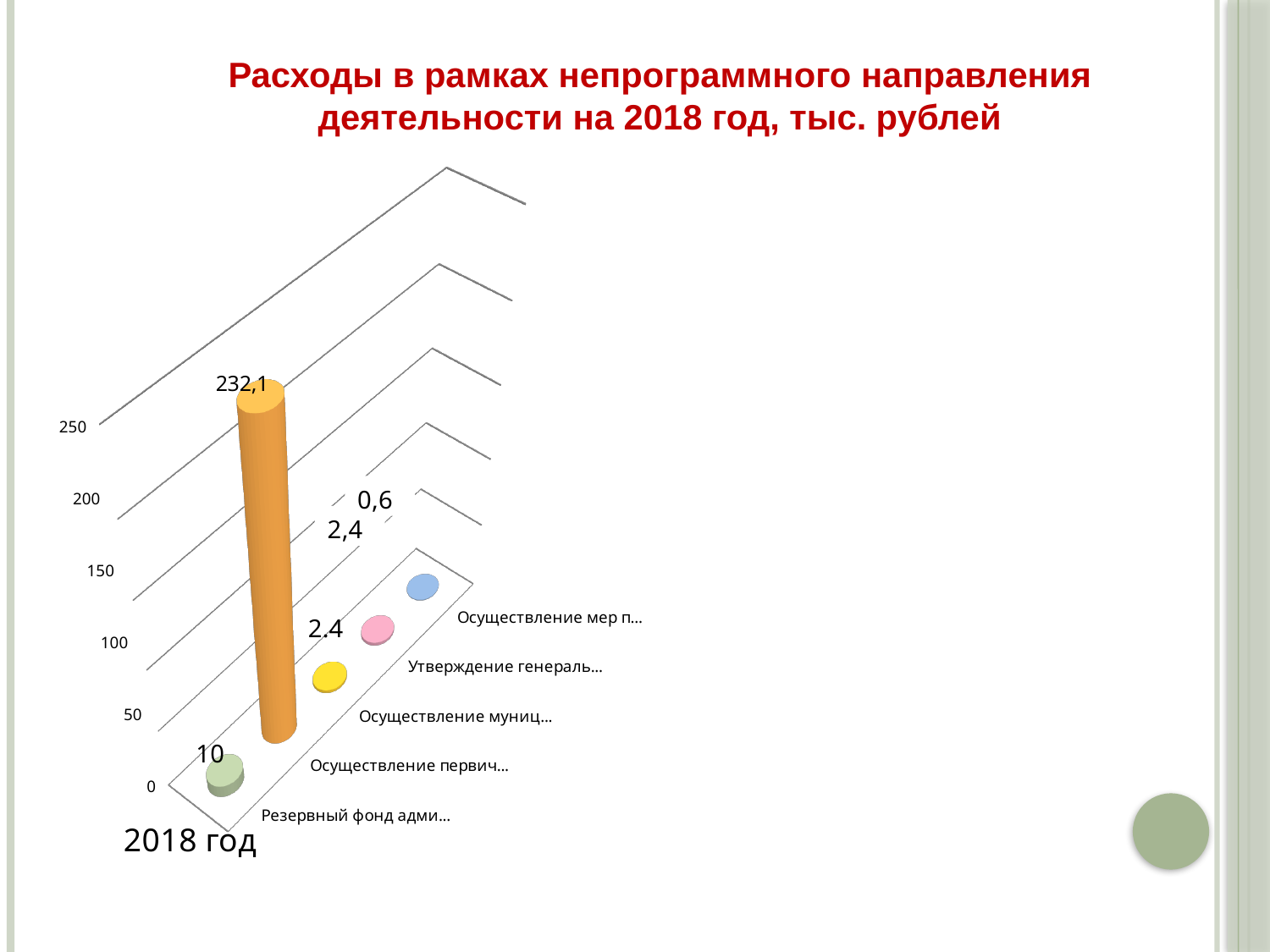
How many categories are plotted in the chart? 5 Which is larger: the value for 'Резервный фонд адми…' or the value for 'Осуществление муниц…'? Резервный фонд адми… What type of chart is shown on the slide? bar chart Which category has the lowest value? Осуществление мер п… What is the value for the category 'Резервный фонд адми…'? 10 Which year is labelled on the chart's horizontal axis? 2018 год What is the value of the tallest bar in the chart? 232,1 Which category has the highest value? Осуществление первич… What is the difference between the values for 'Осуществление первич…' and 'Резервный фонд адми…'? 222,1 Is the value for 'Осуществление первич…' greater or less than 200? greater What is the value for the category 'Утверждение генераль…'? 2,4 What is the value for the category 'Осуществление мер п…'? 0,6